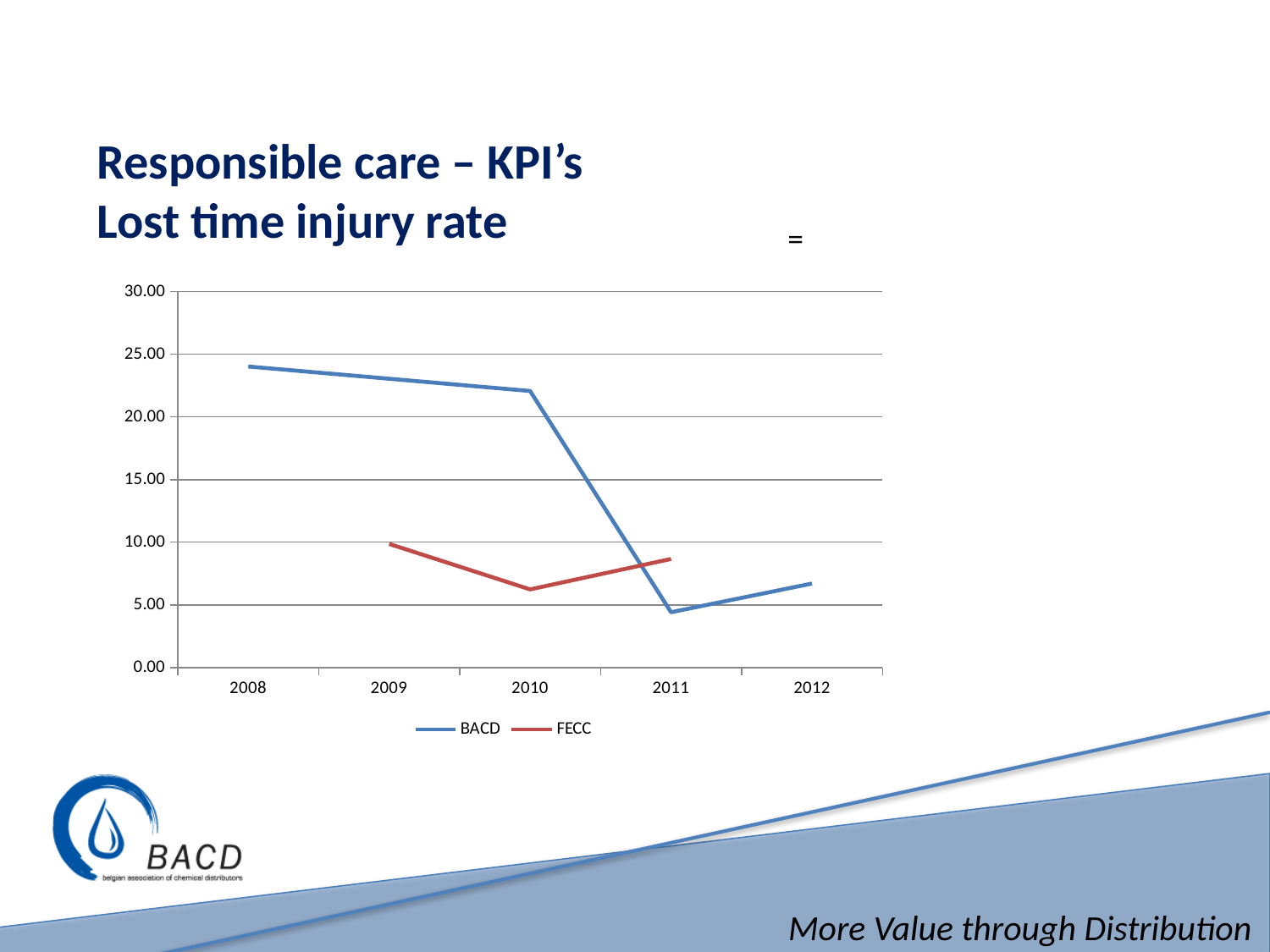
Which series has the larger value in 2010, BACD or FECC? BACD Does the BACD line rise or fall from 2008 to 2011? fall How many series does the legend list? 2 In which year is the BACD value highest? 2008 How many years are shown on the x axis? 5 Which series is drawn in red? FECC Is the BACD value for 2008 greater or less than 20.00? greater What kind of chart is shown on the slide? line chart Is the BACD value for 2011 greater or less than 5.00? less Which series has the larger value in 2011, BACD or FECC? FECC In which year is the BACD value lowest? 2011